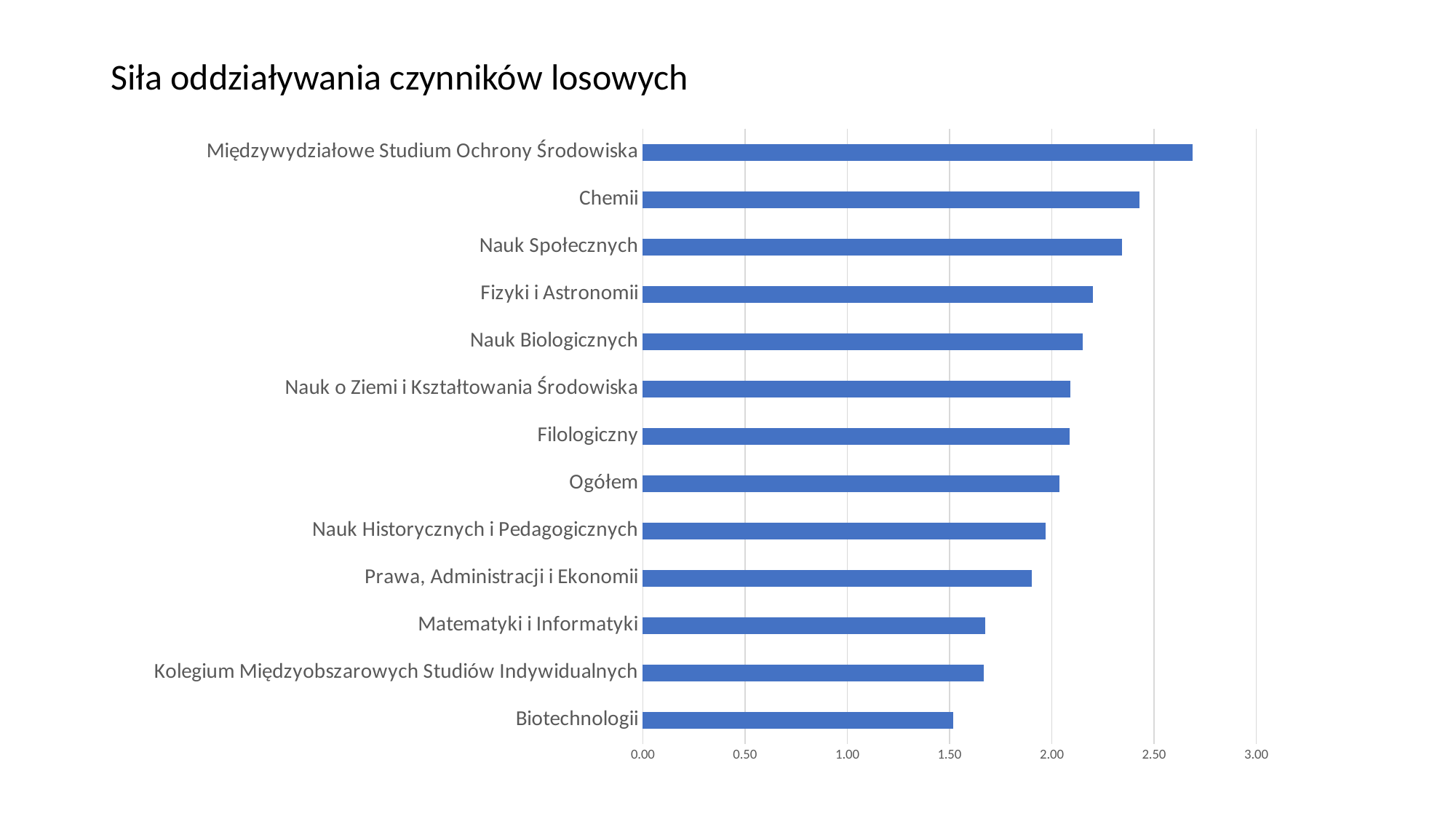
Is the value for Międzywydziałowe Studium Ochrony Środowiska greater or less than 2.50? greater Is the value for Biotechnologii greater or less than 2.00? less Which category has the lowest value? Biotechnologii Which is larger, the value for Ogółem or the value for Biotechnologii? Ogółem Which category has the highest value? Międzywydziałowe Studium Ochrony Środowiska What kind of chart is shown on the slide? Bar chart Which is larger, the value for Chemii or the value for Fizyki i Astronomii? Chemii How many categories are plotted in the chart? 13 Is the value for Nauk Społecznych greater or less than 2.50? less What is the title of the slide? Siła oddziaływania czynników losowych